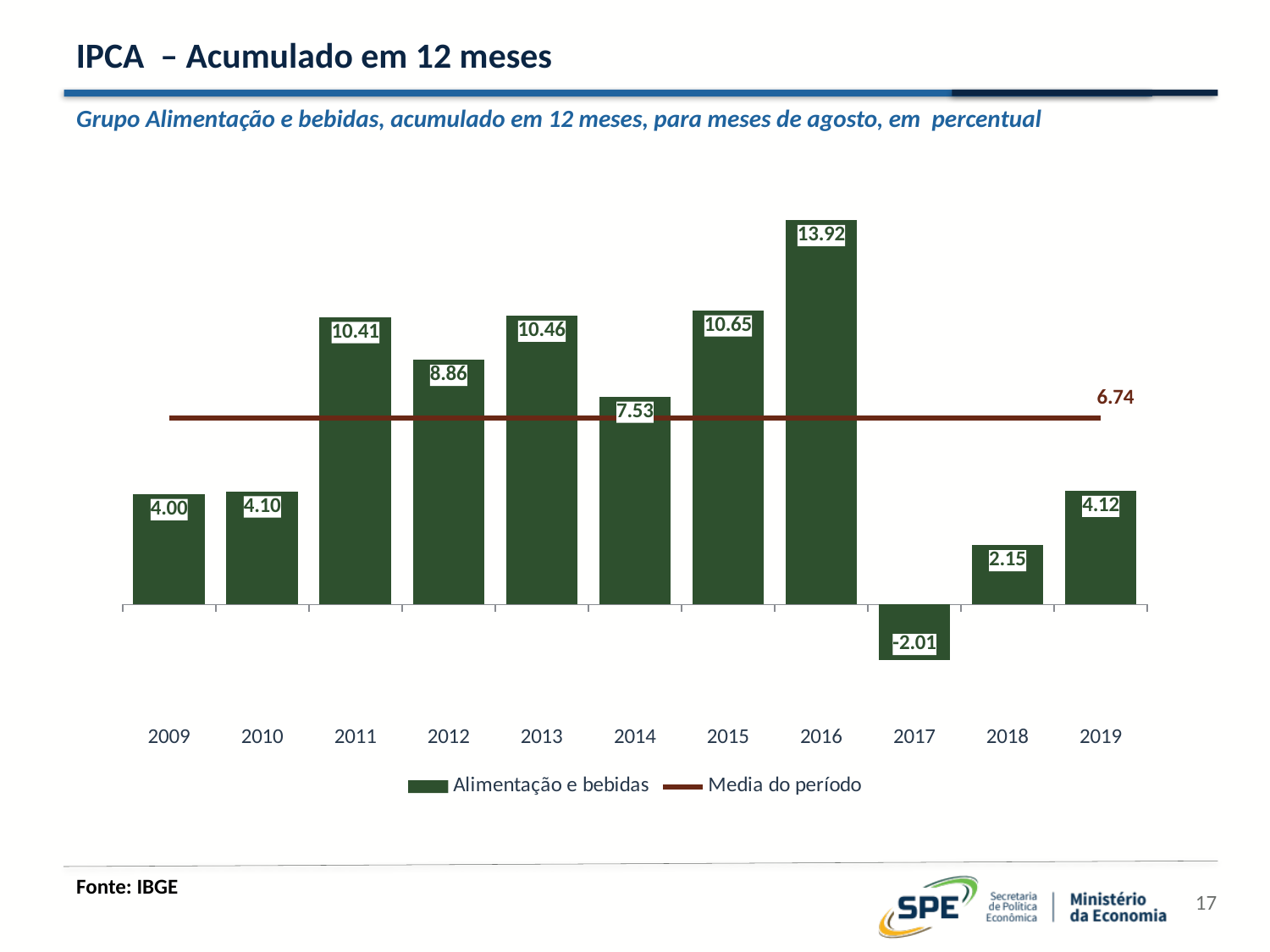
Which year has the highest value for Alimentação e bebidas? 2016 What is the value of the Media do período line? 6.74 How many series does the legend list? 2 What kind of chart is shown on the slide? Combination bar and line chart What is the value for Alimentação e bebidas in 2017? -2.01 What is the value for Alimentação e bebidas in 2016? 13.92 What is the difference between the 2016 and 2015 values for Alimentação e bebidas? 3.27 Do the values for Alimentação e bebidas rise or fall from 2016 to 2017? Fall What is the source cited for the chart? IBGE Which year has the lowest value for Alimentação e bebidas? 2017 How many years are shown on the x axis? 11 Which is larger, the value for 2011 or the value for 2013? 2013